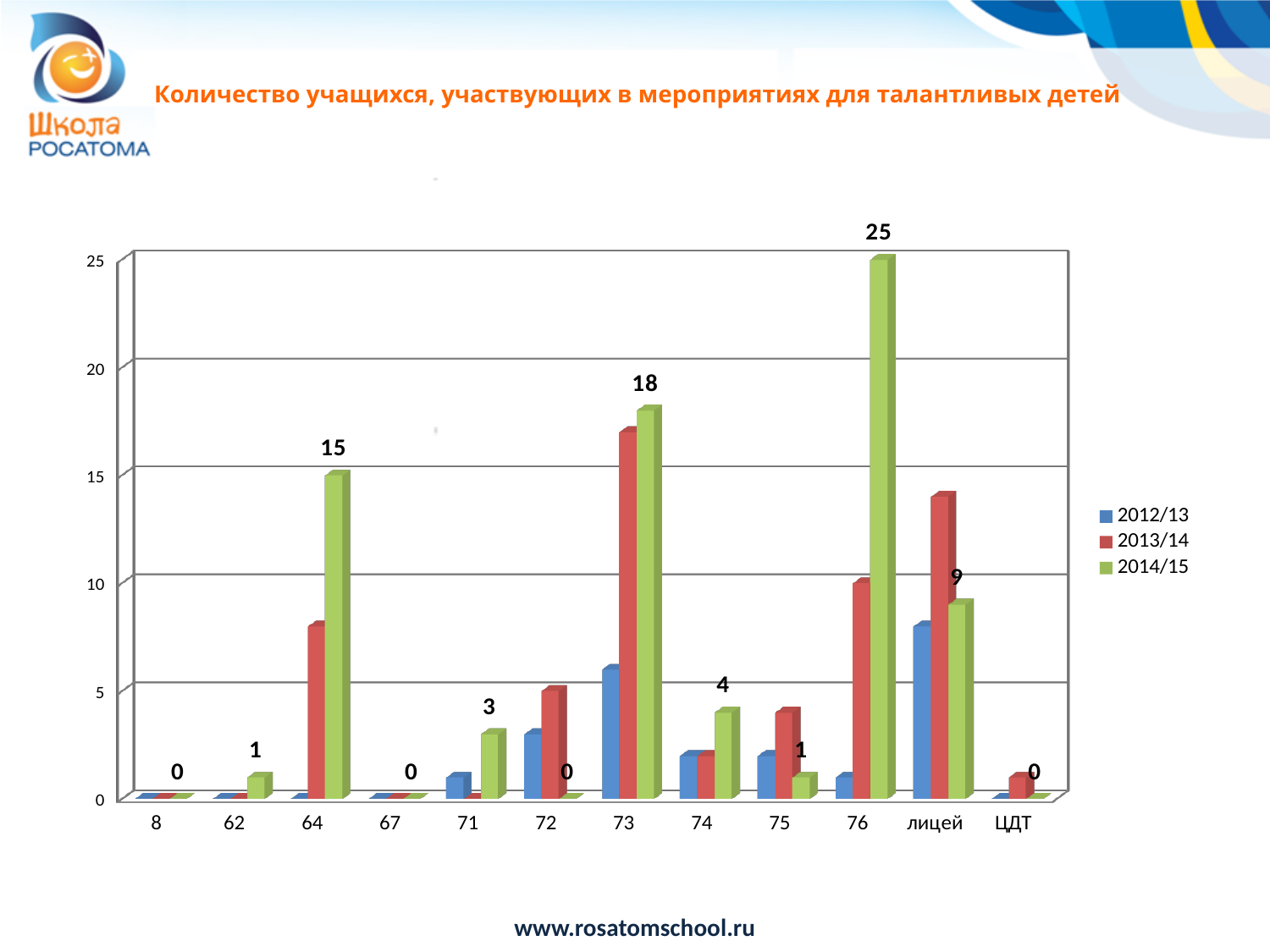
How many series does the legend list? 3 What is the difference between the 2014/15 values for 76 and 73? 7 Is the 2012/13 value for 73 greater or less than 10? less How many categories are shown on the x axis? 12 What is the value for 2014/15 for лицей? 9 What kind of chart is shown on the slide? bar chart Is the 2013/14 value for лицей greater or less than 10? greater What is the value for 2014/15 for category 76? 25 What is the value for 2014/15 for category 73? 18 What is the value for 2014/15 for category 64? 15 Which is larger for 2014/15: the value for 64 or the value for 74? 64 Which category has the highest value for 2014/15? 76